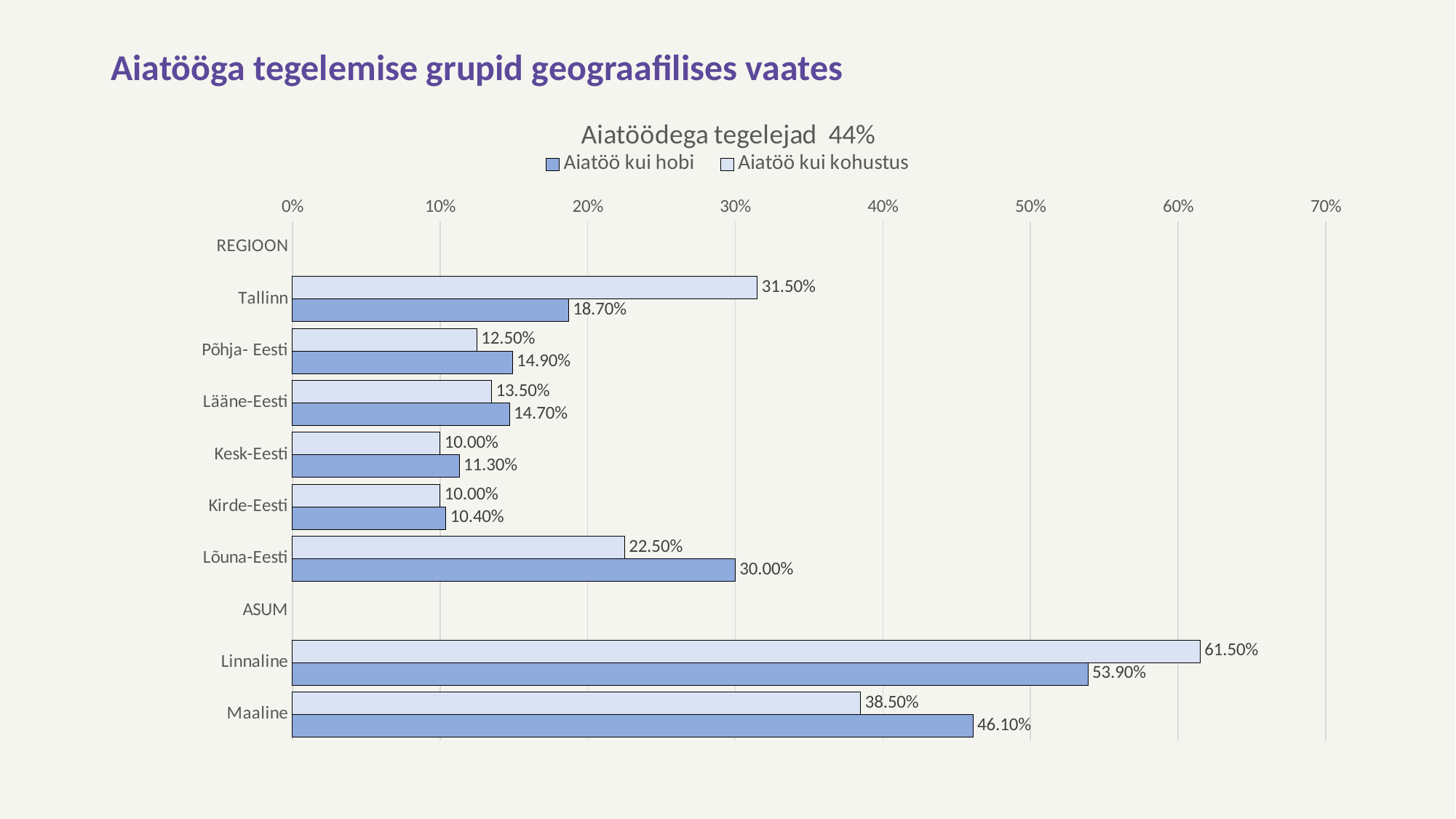
How many series does the legend list? 2 What is the difference between the "Aiatöö kui kohustus" and "Aiatöö kui hobi" values for Tallinn? 12.80% How many regions are listed under the REGIOON group? 6 Is the "Aiatöö kui hobi" value for Maaline greater or less than 40%? greater For Lõuna-Eesti, which series has the larger value: "Aiatöö kui hobi" or "Aiatöö kui kohustus"? Aiatöö kui hobi Which category has the highest value in the "Aiatöö kui kohustus" series? Linnaline Which category has the lowest value in the "Aiatöö kui hobi" series? Kirde-Eesti What is the value for Lõuna-Eesti in the "Aiatöö kui hobi" series? 30.00% What is the difference between the "Aiatöö kui kohustus" and "Aiatöö kui hobi" values for Linnaline? 7.60% What type of chart is shown on the slide? Bar chart What is the value for Tallinn in the "Aiatöö kui kohustus" series? 31.50% What is the value for Maaline in the "Aiatöö kui kohustus" series? 38.50%